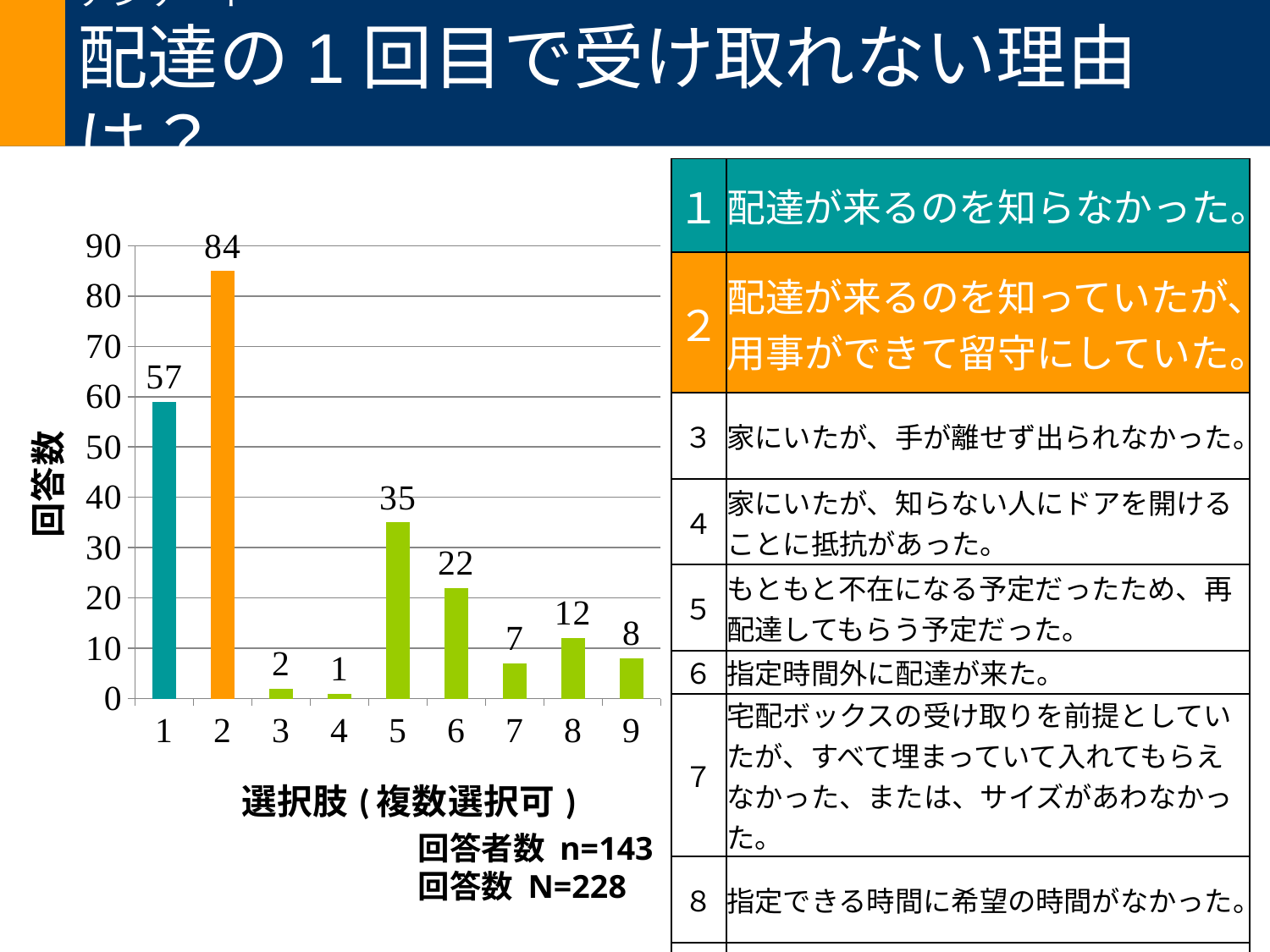
Is the value for category 1 greater or less than 50? greater What is the value for category 2? 84 Which is larger, the value for category 7 or the value for category 9? 9 What is the value for category 8? 12 What is the difference between the values for category 5 and category 6? 13 Which category has the lowest value? 4 What is the value for category 5? 35 What is the label of the y axis? 回答数 What is the difference between the values for category 2 and category 1? 27 What kind of chart is shown on the slide? bar chart Which category has the highest value? 2 How many categories are shown on the x axis? 9